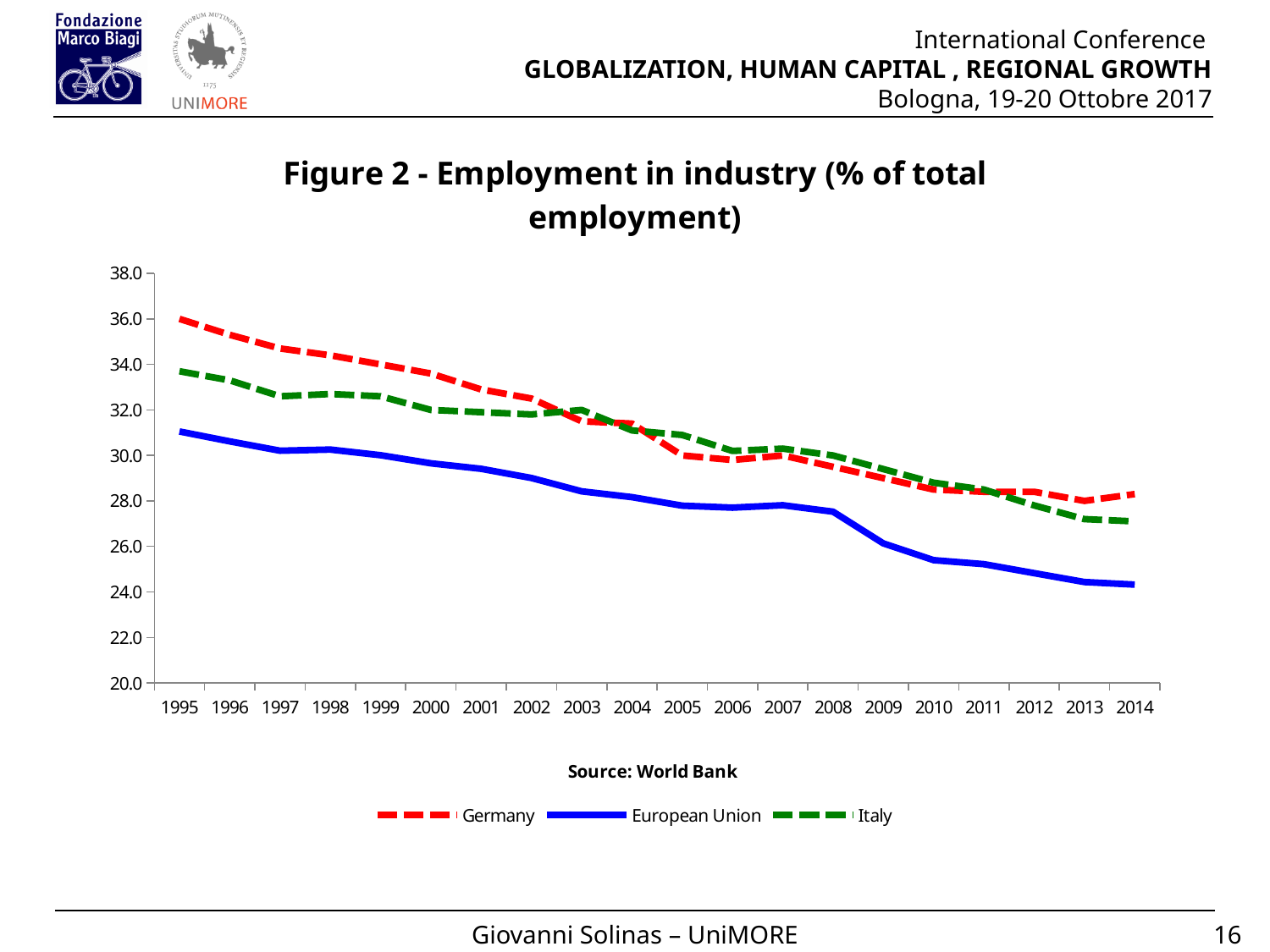
In 1995, which is larger: the value for Germany or the value for the European Union? Germany Which series has the highest value in 1995? Germany Is the value for Germany in 1995 greater or less than 34.0? greater Is the value for Italy in 2014 greater or less than 28.0? less Do the values for the European Union rise or fall from 1995 to 2014? fall What source is cited below the chart? World Bank Which series has the lowest value in 2014? European Union What kind of chart is shown on the slide? line chart How many years are shown on the x axis? 20 In 2014, which is larger: the value for Germany or the value for Italy? Germany Is the value for the European Union in 2014 greater or less than 26.0? less How many series does the legend list? 3